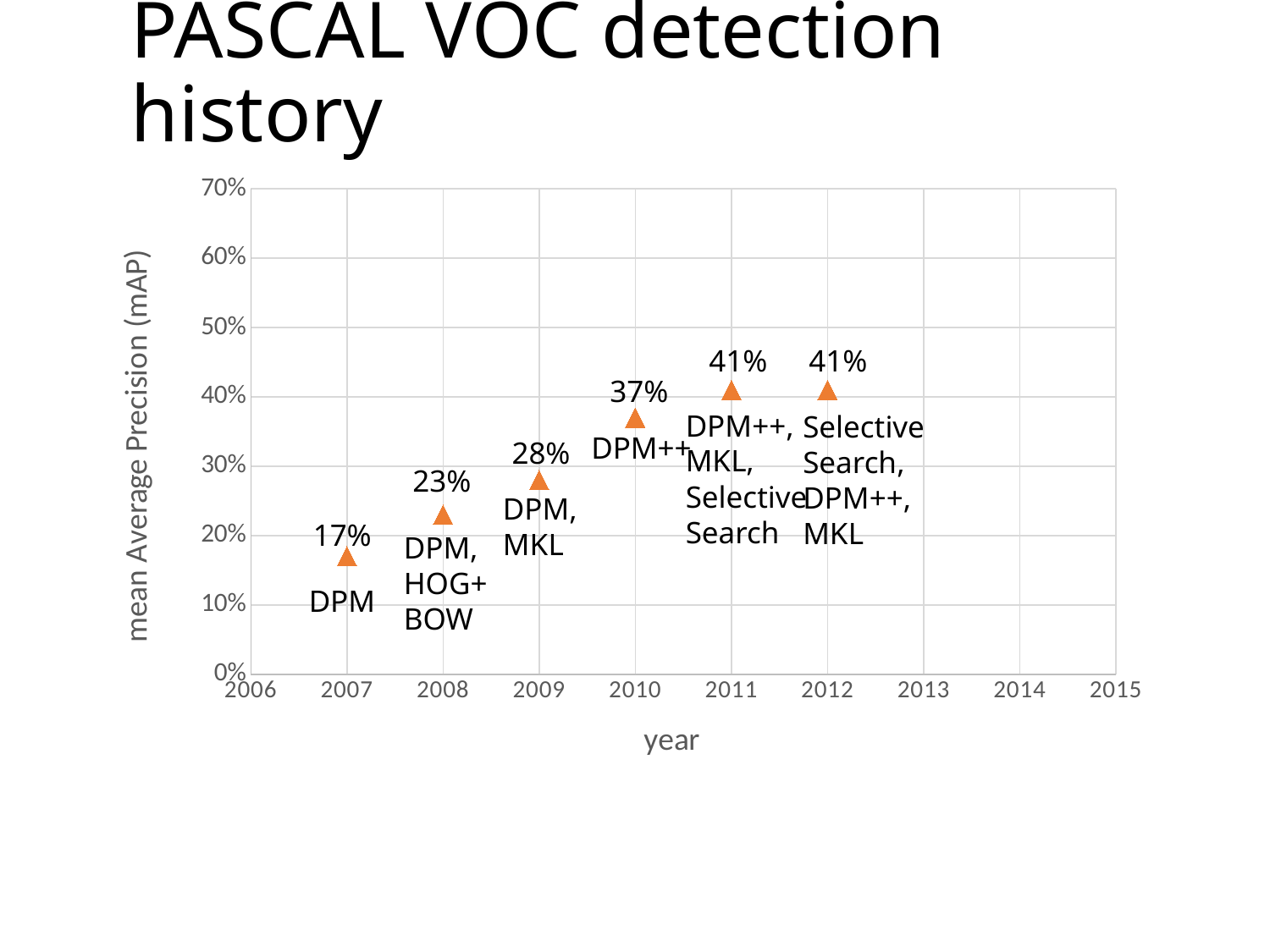
What is the mean Average Precision (mAP) value for 2007? 17% What kind of chart is shown on the slide? scatter chart What is the difference between the mAP values for 2010 and 2008? 14% How many data points are plotted on the chart? 6 Do the mAP values generally rise or fall from 2007 to 2012? rise Which year has a larger mAP value, 2008 or 2009? 2009 What is the mAP value plotted for 2009? 28% Is the mAP value for 2010 greater or less than 30%? greater Which year has the lowest mAP value? 2007 What is the mAP value plotted for 2010? 37% What is the highest mAP value shown on the chart? 41% What is the difference between the mAP values for 2011 and 2007? 24%